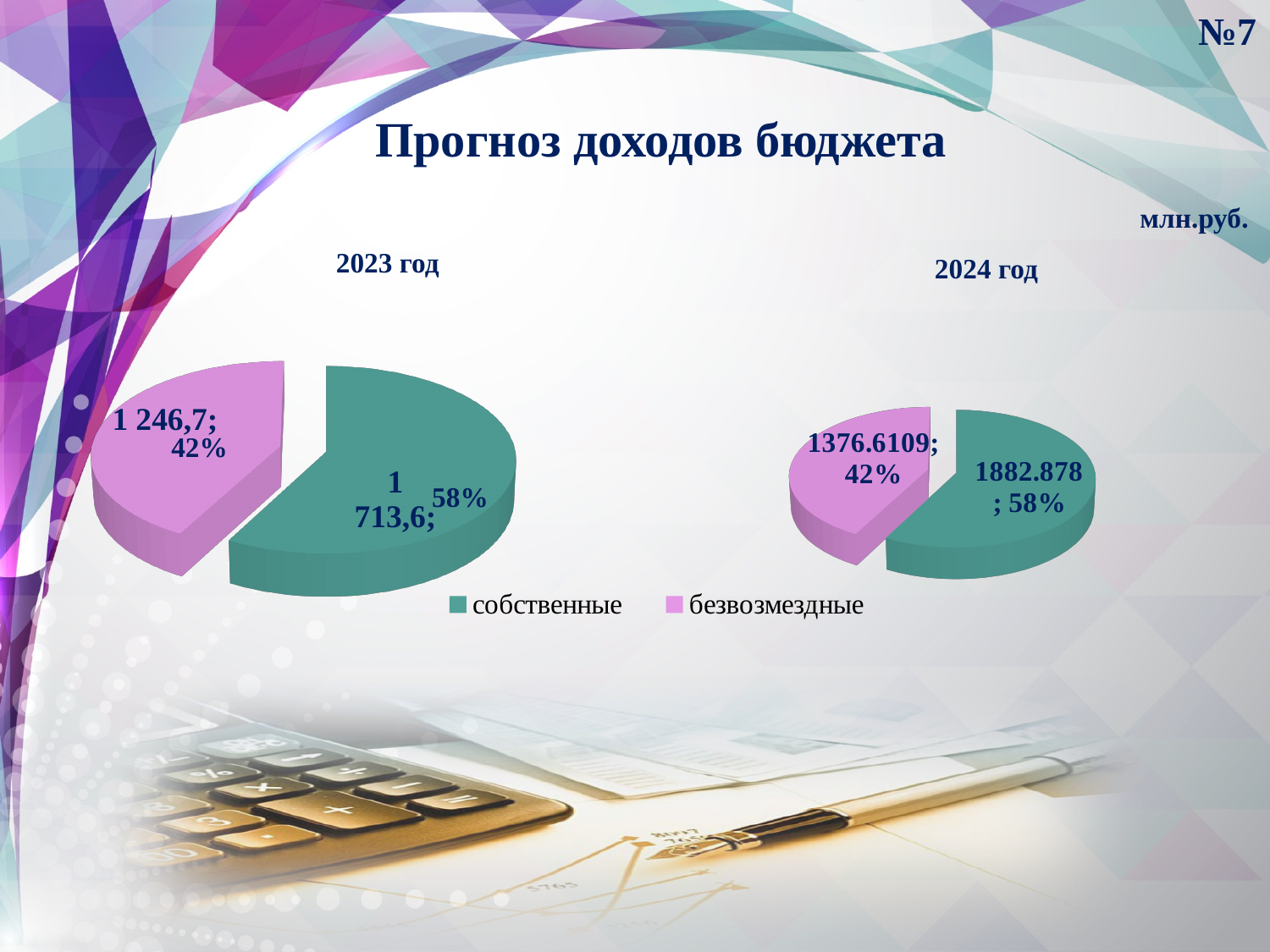
In the 2023 год chart, what is the value for безвозмездные? 1 246,7 What colour represents безвозмездные in the pie charts? pink In the 2024 год chart, what share of the pie does собственные take? 58% In the 2023 год chart, what share of the pie does безвозмездные take? 42% In the 2023 год chart, what is the value for собственные? 1 713,6 In the 2024 год chart, what is the value for собственные? 1882.878 How many categories does the legend list for the pie charts? 2 In the 2024 год chart, what is the value for безвозмездные? 1376.6109 In the 2024 год chart, which category is the largest? собственные In the 2023 год chart, which category is the smallest? безвозмездные What kind of chart is used for the 2023 год data? pie chart In the 2023 год chart, what is the difference between собственные and безвозмездные? 466,9